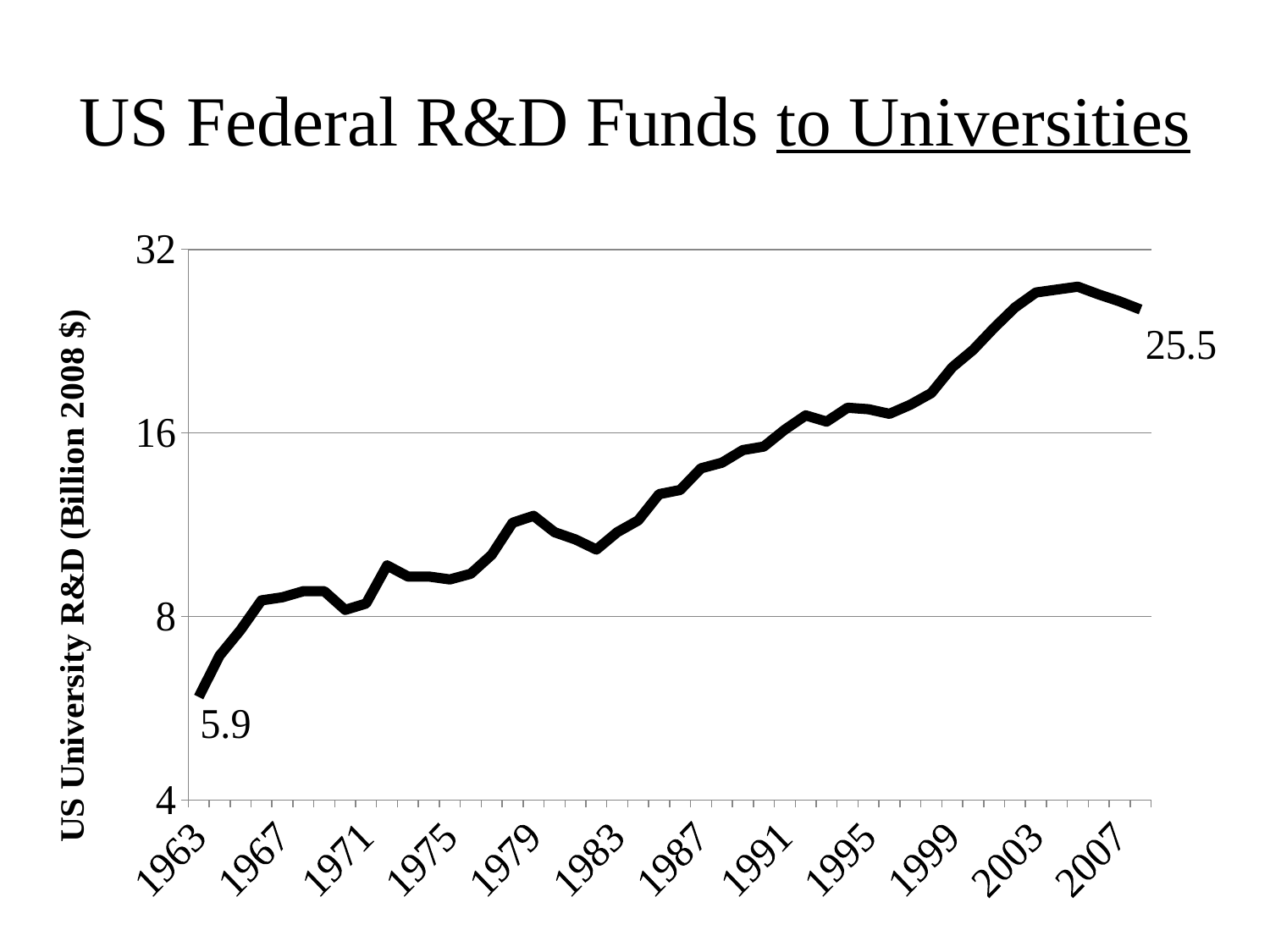
Is the value for 1983 greater or less than 16? less Is the value for 1979 greater or less than 8? greater What is the value of US University R&D in 1963? 5.9 What is the difference between the last labelled value (25.5) and the 1963 value (5.9)? 19.6 Which year has the lowest value on the chart? 1963 What is the title of the slide? US Federal R&D Funds to Universities What is the title of the chart's vertical axis? US University R&D (Billion 2008 $) Is the value for 2003 greater or less than 16? greater What is the value labelled at the rightmost end of the line? 25.5 What kind of chart is shown on the slide? line chart Overall, do the values rise or fall from 1963 to the end of the series? rise Which is larger, the value for 1979 or the value for 1983? 1979